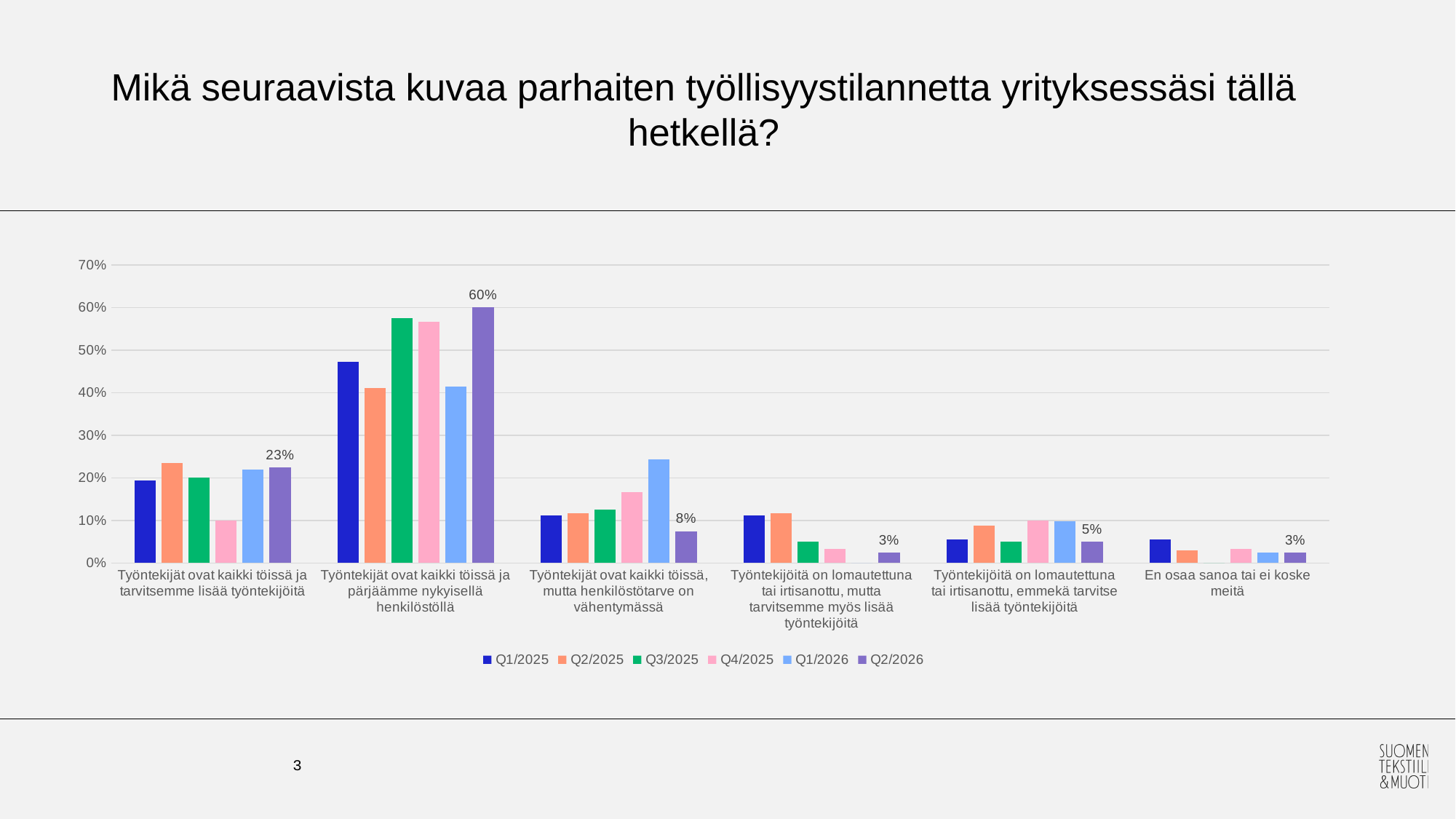
Which category has the highest Q2/2026 value? Työntekijät ovat kaikki töissä ja pärjäämme nykyisellä henkilöstöllä Is the Q1/2025 value for "Työntekijät ovat kaikki töissä ja pärjäämme nykyisellä henkilöstöllä" greater or less than 40%? greater What is the Q2/2026 value for "Työntekijät ovat kaikki töissä ja tarvitsemme lisää työntekijöitä"? 23% What kind of chart is shown on the slide? bar chart Is the Q4/2025 value for "Työntekijät ovat kaikki töissä ja tarvitsemme lisää työntekijöitä" greater or less than 20%? less How many categories are shown on the x axis? 6 What is the Q2/2026 value for "Työntekijöitä on lomautettuna tai irtisanottu, emmekä tarvitse lisää työntekijöitä"? 5% For Q2/2026, which is larger: the value for "Työntekijät ovat kaikki töissä ja tarvitsemme lisää työntekijöitä" or for "Työntekijät ovat kaikki töissä, mutta henkilöstötarve on vähentymässä"? Työntekijät ovat kaikki töissä ja tarvitsemme lisää työntekijöitä What is the difference between the Q2/2026 values for "Työntekijät ovat kaikki töissä ja pärjäämme nykyisellä henkilöstöllä" and "Työntekijät ovat kaikki töissä ja tarvitsemme lisää työntekijöitä"? 37 percentage points What is the Q2/2026 value for "Työntekijät ovat kaikki töissä ja pärjäämme nykyisellä henkilöstöllä"? 60% How many series does the legend list? 6 What is the Q2/2026 value for "Työntekijät ovat kaikki töissä, mutta henkilöstötarve on vähentymässä"? 8%